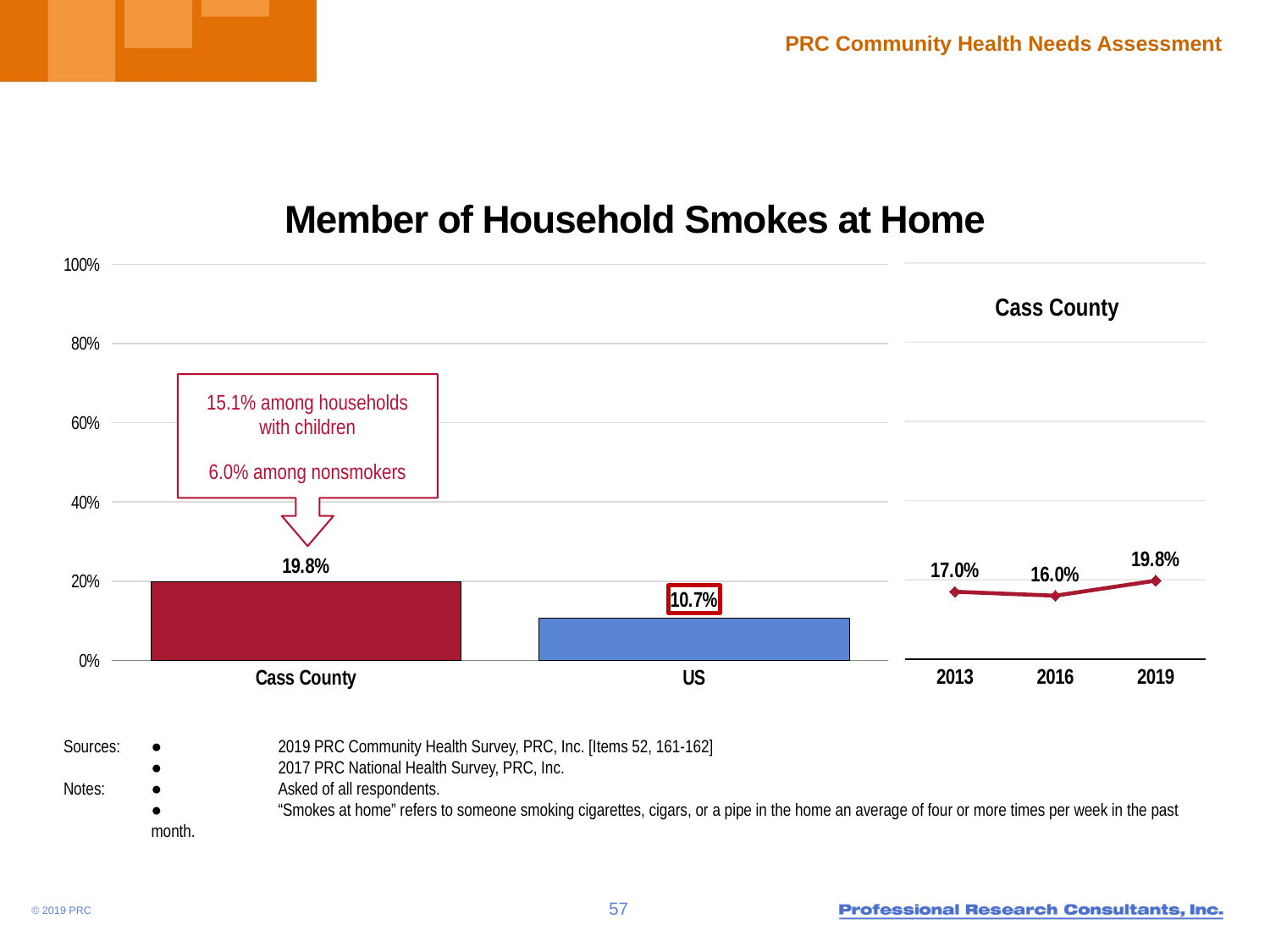
In the bar chart on the left, which category has the higher value, Cass County or US? Cass County What is the title of the chart on the slide? Member of Household Smokes at Home In the Cass County trend chart on the right, what is the difference between the 2019 value and the 2016 value? 3.8% In the Cass County trend chart on the right, which year has the highest value? 2019 What kind of chart is the chart on the left? bar chart In the Cass County trend chart on the right, what is the value for 2013? 17.0% In the bar chart on the left, what is the value for Cass County? 19.8% In the bar chart on the left, what is the value for US? 10.7% In the bar chart on the left, what is the difference between the Cass County value and the US value? 9.1% In the Cass County trend chart on the right, what is the value for 2016? 16.0% In the bar chart on the left, how many categories are shown? 2 In the Cass County trend chart on the right, which year has the lowest value? 2016